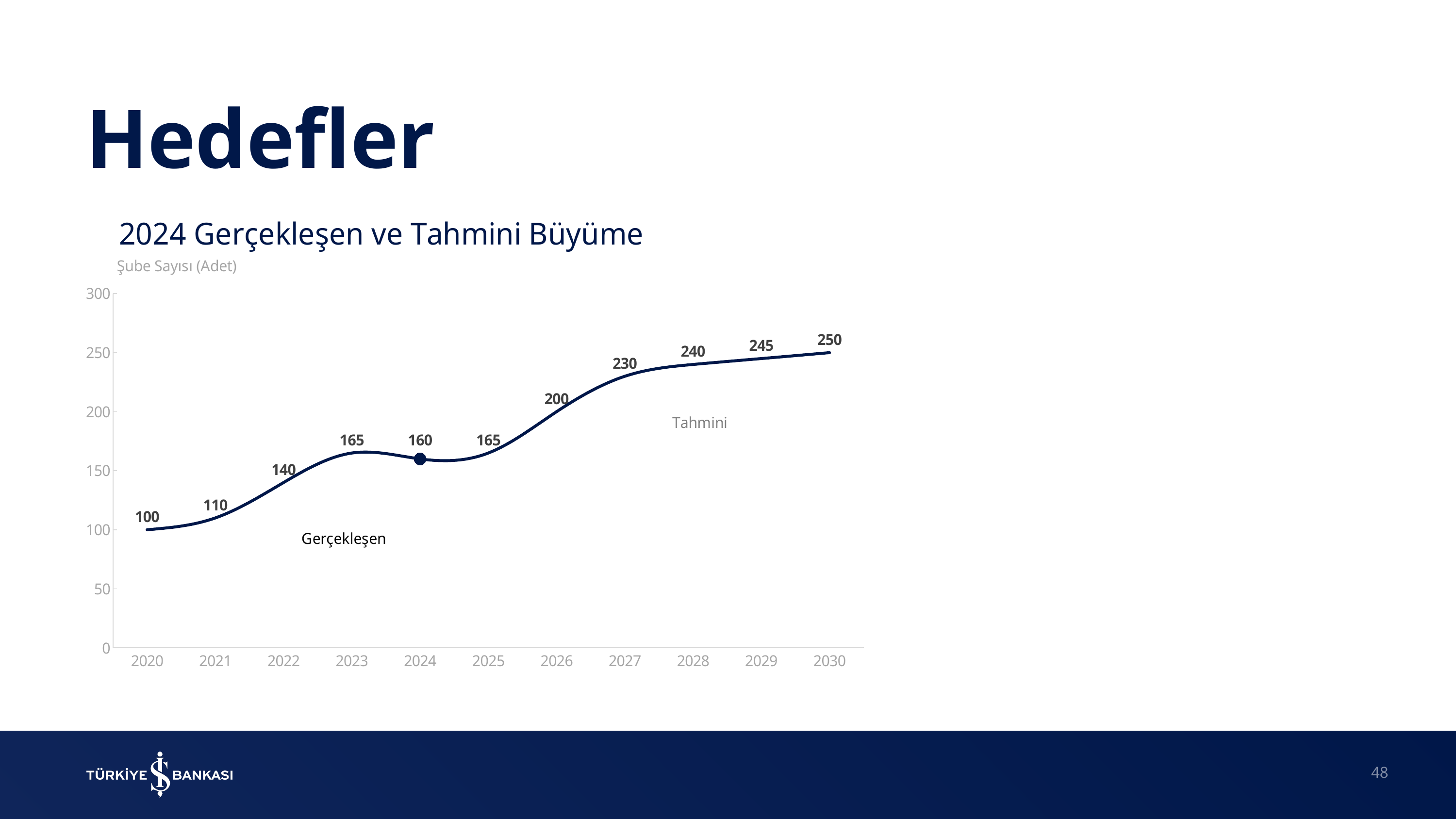
What is the value for 2020? 100 What is the difference between the values for 2030 and 2024? 90 What is the value for 2030? 250 How many years are plotted on the x axis? 11 Do the values generally rise or fall from 2020 to 2030? Rise What is the title of the chart? 2024 Gerçekleşen ve Tahmini Büyüme What is the value for 2024? 160 Which is larger, the value for 2023 or the value for 2024? 2023 Which year has the highest value? 2030 What is the value for 2027? 230 Which year has the lowest value? 2020 What kind of chart is shown on the slide? Line chart